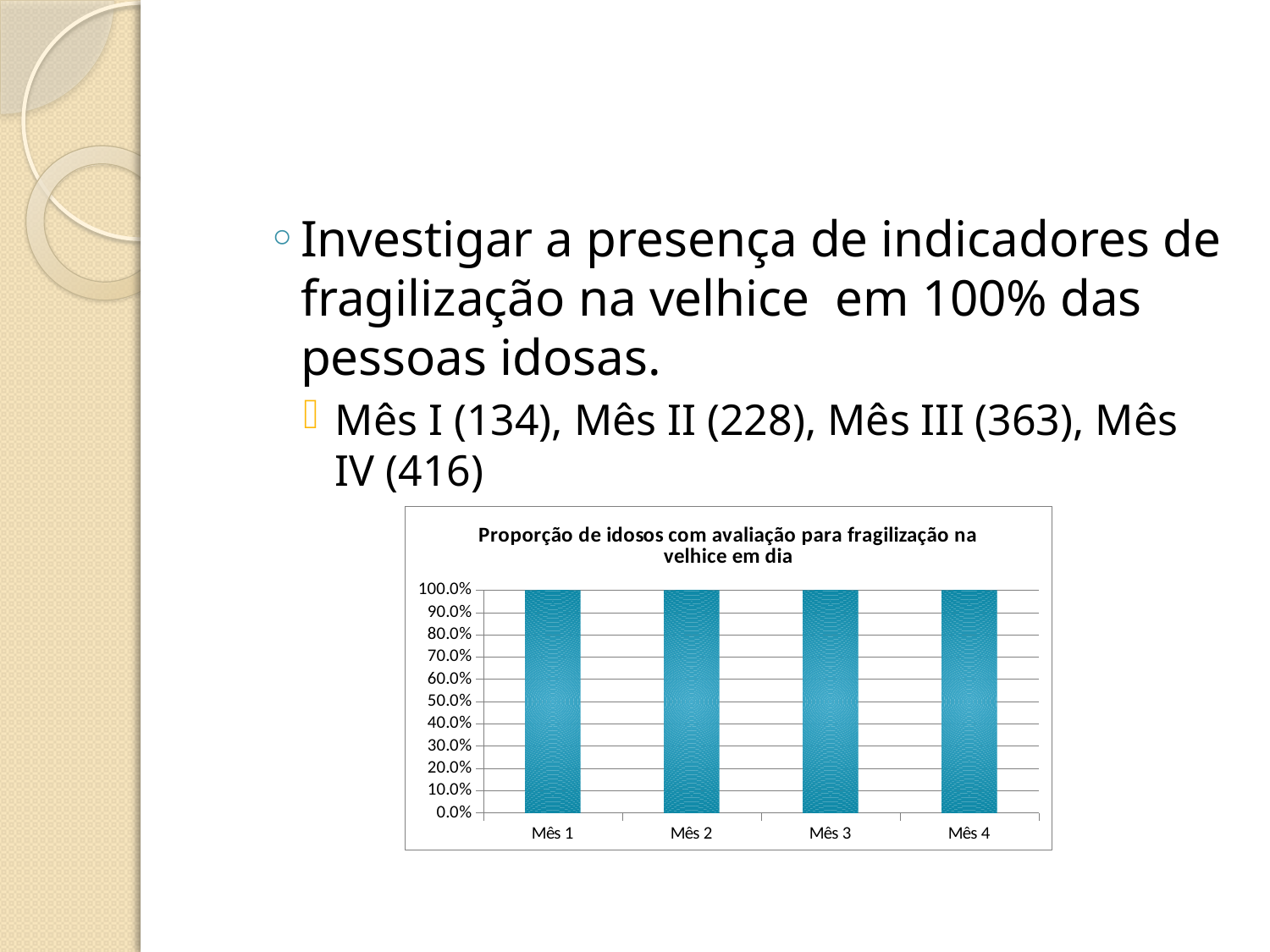
Is the value for Mês 4 greater or less than 90.0%? greater What is the title of the chart? Proporção de idosos com avaliação para fragilização na velhice em dia Is the value for Mês 2 greater or less than 50.0%? greater What is the value for Mês 2 on the chart? 100.0% Do the values rise, fall, or stay the same from Mês 1 to Mês 4? stay the same What is the highest value shown on the chart's vertical axis? 100.0% What kind of chart is shown on the slide? bar chart What is the value for Mês 4 on the chart? 100.0% What is the difference between the values for Mês 3 and Mês 1? 0.0% How many categories (months) are plotted on the chart? 4 What is the value for Mês 3 on the chart? 100.0% What is the value for Mês 1 on the chart? 100.0%